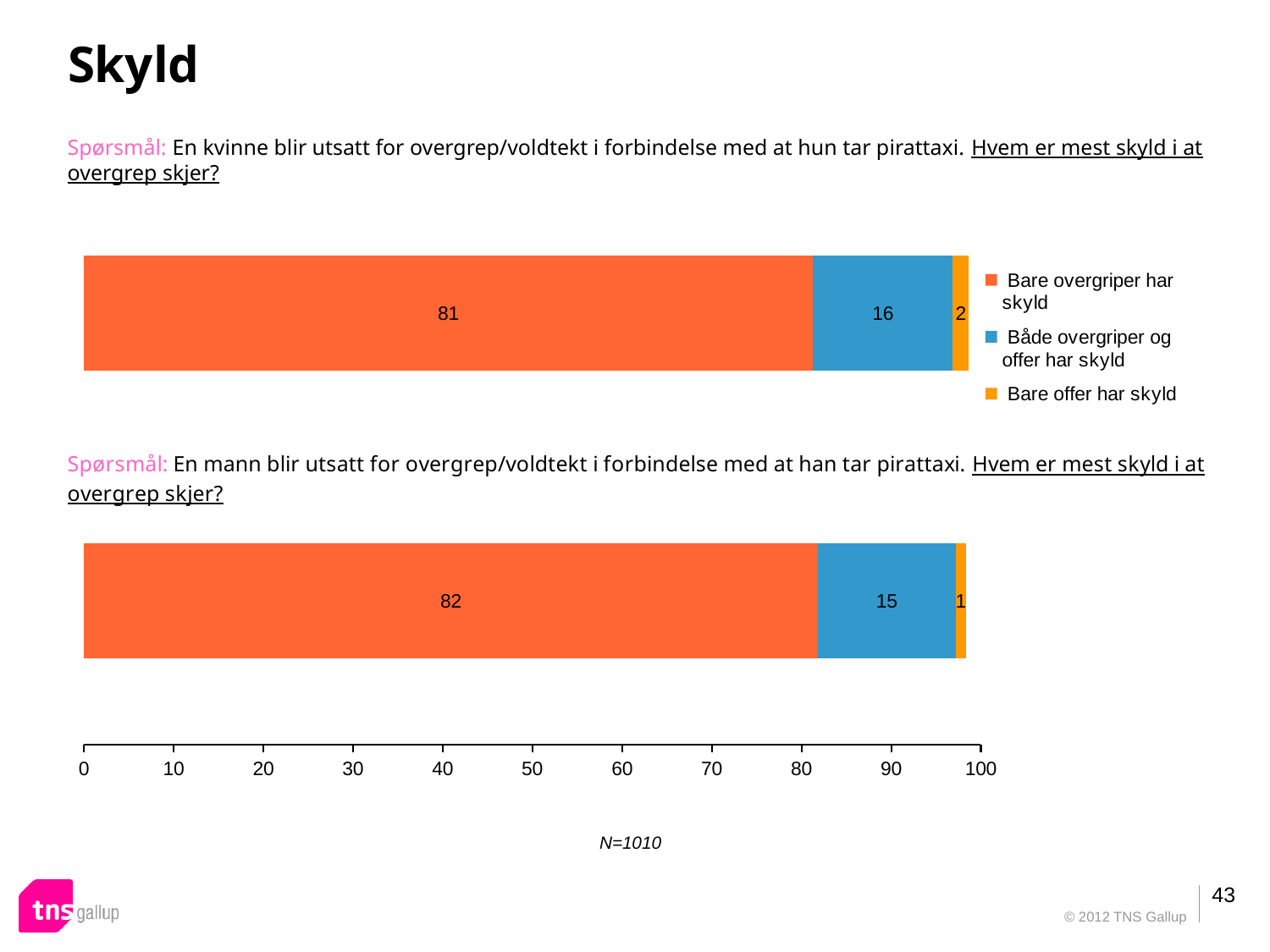
In the bottom chart (man taking pirate taxi), what is the value for "Bare overgriper har skyld"? 82 In the bottom chart (man taking pirate taxi), what is the value for "Både overgriper og offer har skyld"? 15 What kind of chart is used on this slide? Stacked bar chart In the bottom chart, which response has the lowest value? Bare offer har skyld In the top chart, what is the difference between "Bare overgriper har skyld" and "Både overgriper og offer har skyld"? 65 In the bottom chart (man taking pirate taxi), what is the value for "Bare offer har skyld"? 1 How many series does the legend list? 3 In the top chart (woman taking pirate taxi), what is the value for "Både overgriper og offer har skyld"? 16 In the top chart, which response has the highest value? Bare overgriper har skyld Which is larger: "Bare overgriper har skyld" in the top chart or in the bottom chart? Bottom chart (82) In the top chart (woman taking pirate taxi), what is the value for "Bare offer har skyld"? 2 In the top chart (woman taking pirate taxi), what is the value for "Bare overgriper har skyld"? 81